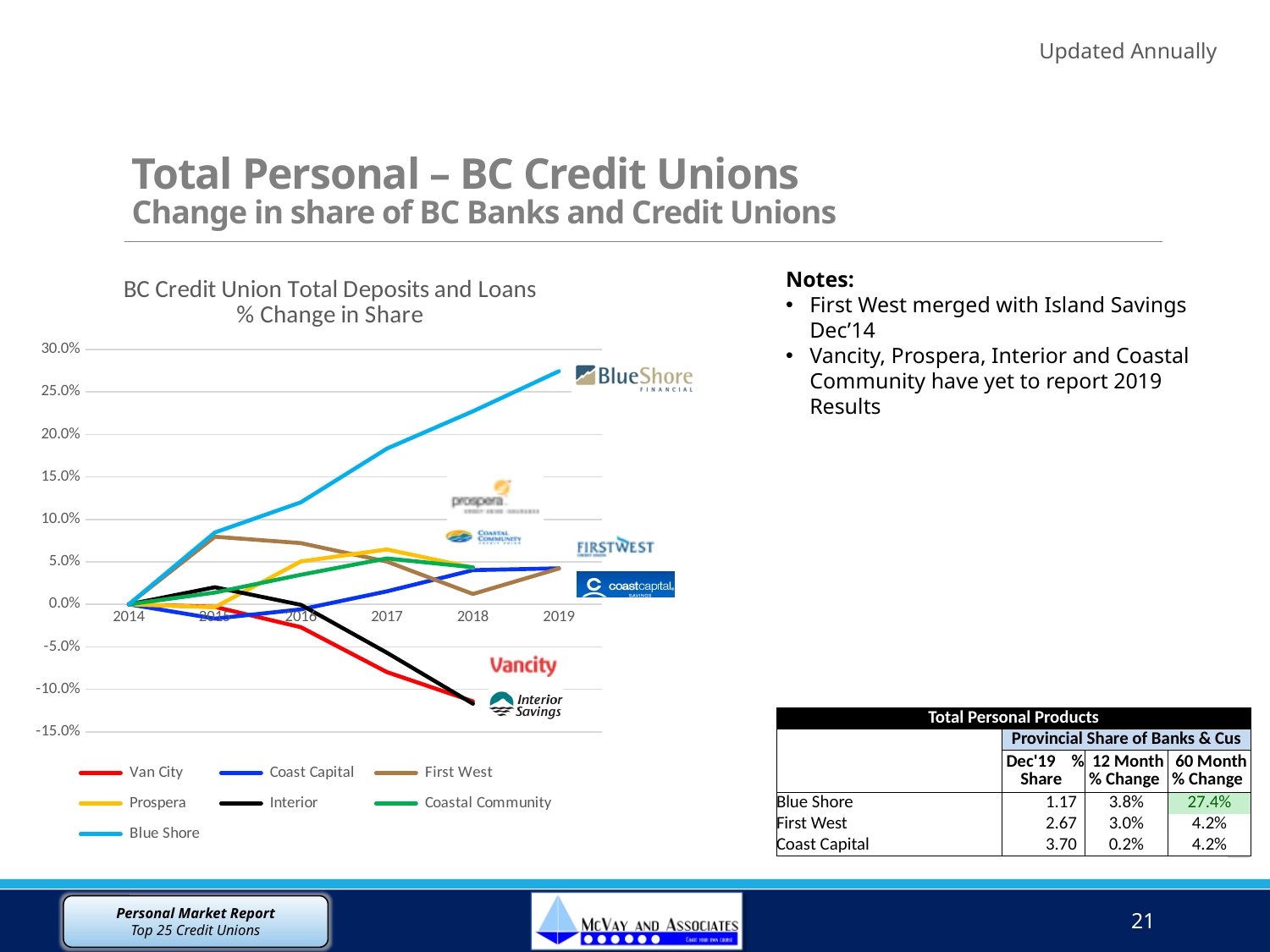
In 2019, which is larger: the value for Blue Shore or the value for First West? Blue Shore Does the Blue Shore line rise or fall from 2014 to 2019? rise In 2017, which is larger: the value for Coast Capital or the value for Van City? Coast Capital Is the value for Blue Shore in 2017 greater or less than 15.0%? greater What kind of chart is shown on the slide? line chart How many series does the chart legend list? 7 How many years are shown along the x axis of the chart? 6 Is the value for Van City in 2017 greater or less than -5.0%? less Which series has the highest value in 2019? Blue Shore Is the value for Blue Shore in 2019 greater or less than 25.0%? greater What is the title of the chart? BC Credit Union Total Deposits and Loans % Change in Share